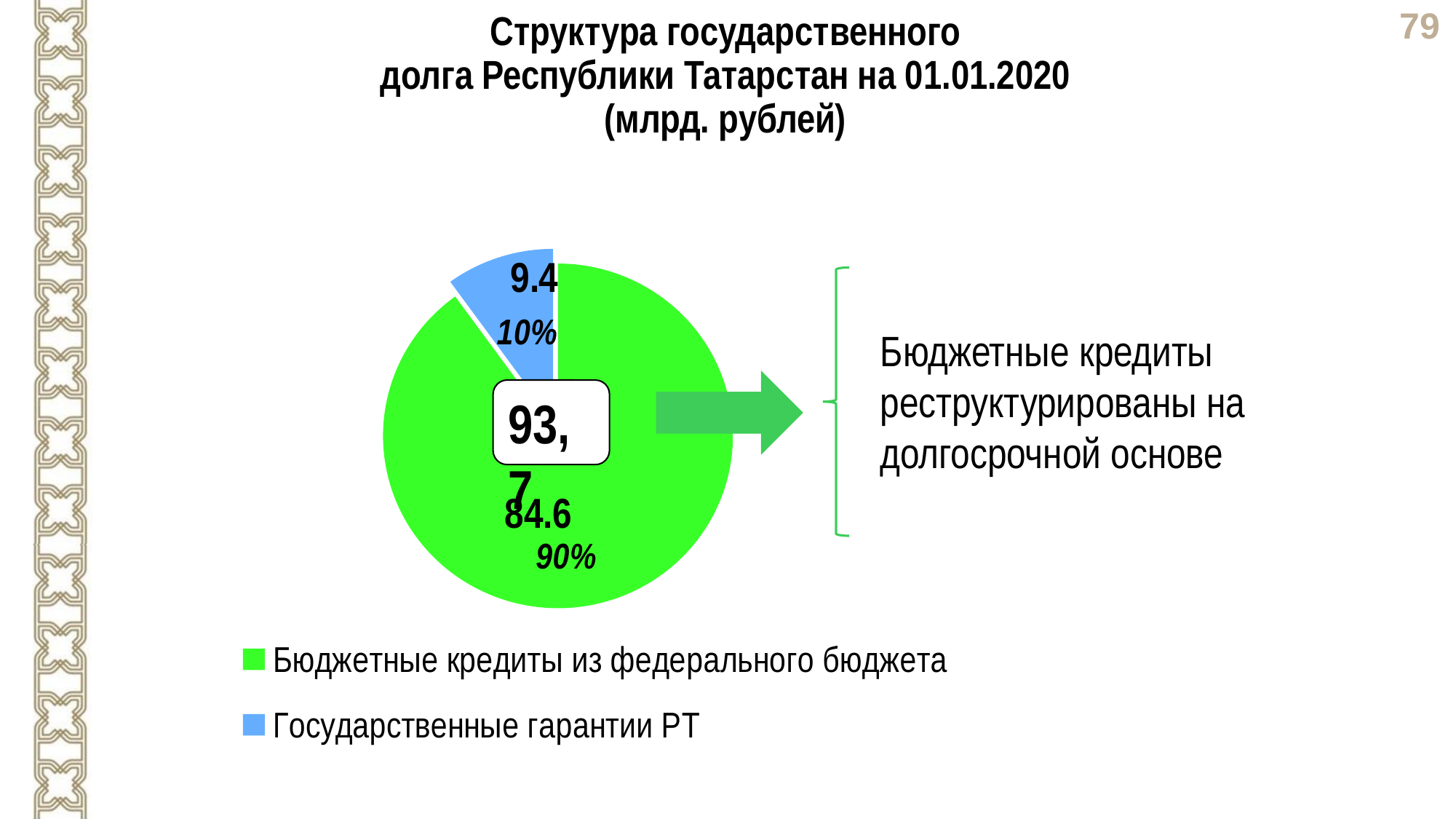
What is the value for Бюджетные кредиты из федерального бюджета? 84.6 What share of the pie does Бюджетные кредиты из федерального бюджета represent? 90% Which category has the largest slice of the pie? Бюджетные кредиты из федерального бюджета What share of the pie does Государственные гарантии РТ represent? 10% Which is larger: Бюджетные кредиты из федерального бюджета or Государственные гарантии РТ? Бюджетные кредиты из федерального бюджета What is the value for Государственные гарантии РТ? 9.4 What colour is the slice for Государственные гарантии РТ? blue What total value is shown in the centre of the pie chart? 93,7 What kind of chart is shown on the slide? pie chart Which category has the smallest slice of the pie? Государственные гарантии РТ What is the difference between the values for Бюджетные кредиты из федерального бюджета and Государственные гарантии РТ? 75.2 How many categories does the pie chart have? 2